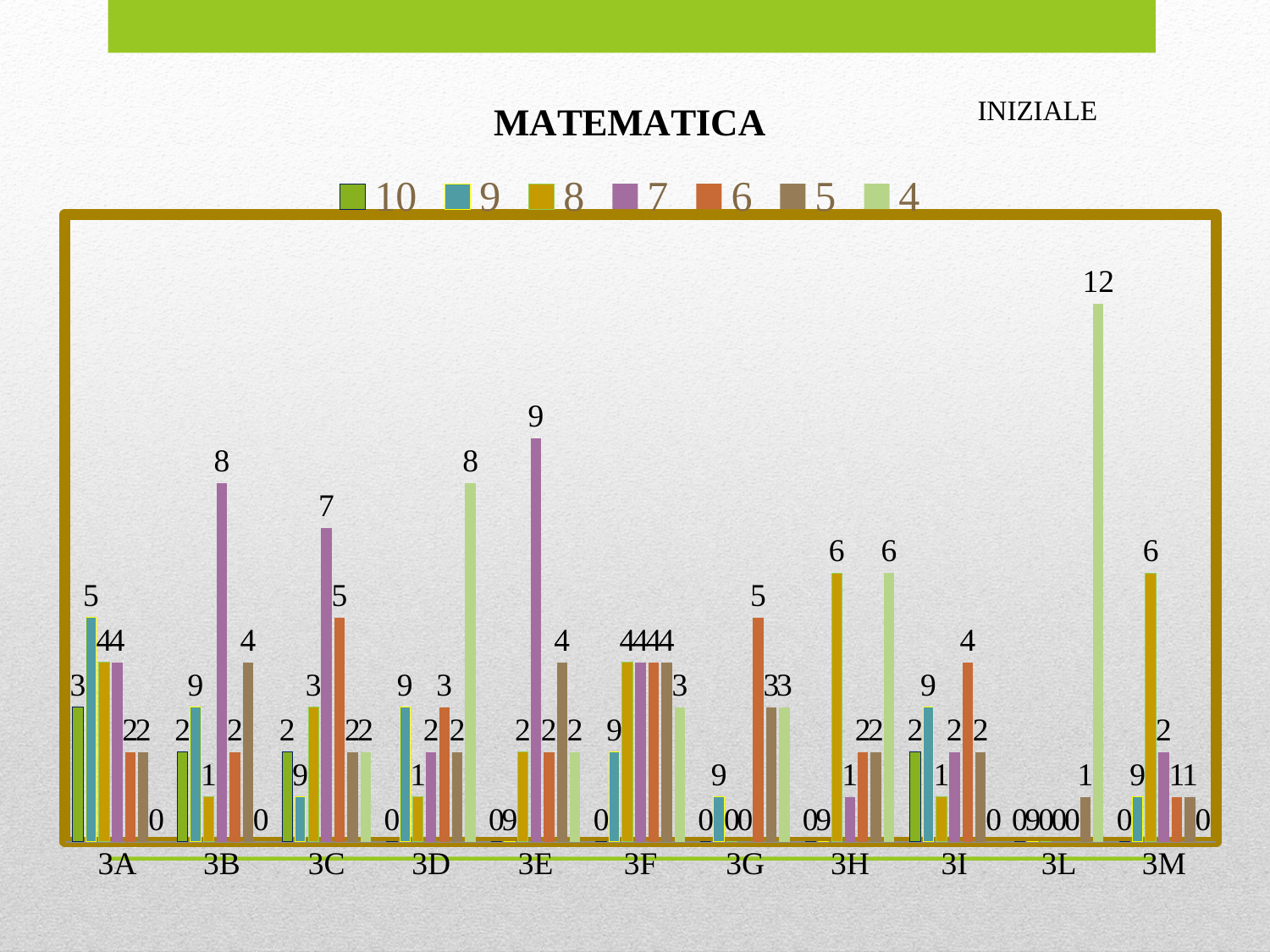
What is the value of series 7 for class 3B? 8 Which is larger: the series 7 value for 3B or the series 7 value for 3C? 3B How many classes (categories) are shown on the x axis? 11 What kind of chart is shown on the slide? bar chart How many series does the legend list? 7 What is the value of series 8 for class 3H? 6 What is the value of series 7 for class 3E? 9 What is the value of series 4 for class 3M? 0 What is the difference between the series 4 value for 3M and the series 4 value for 3D? 8 What is the value of series 6 for class 3G? 5 Which class has the tallest bar in the whole chart? 3L What is the title of the chart? MATEMATICA